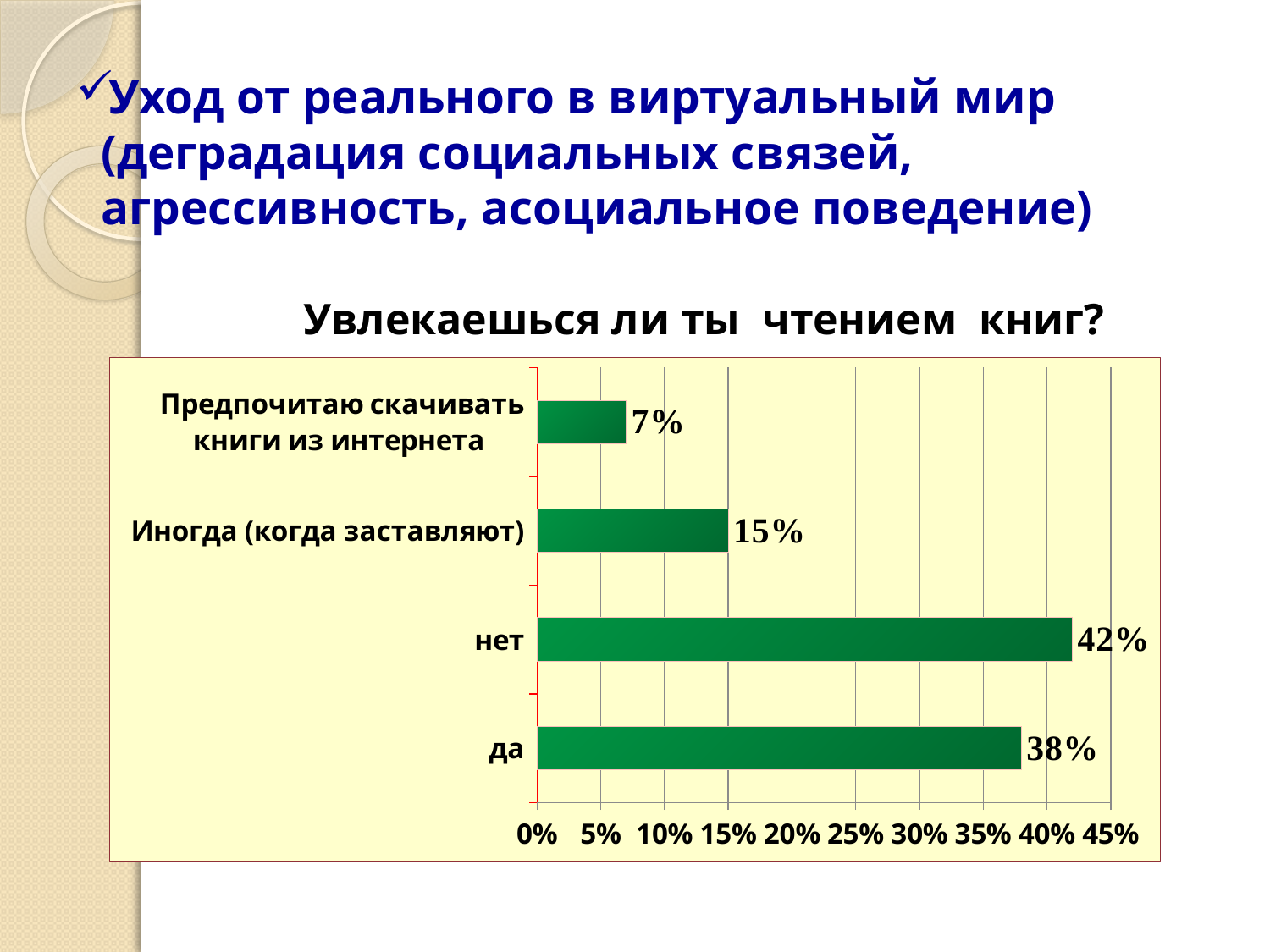
What percentage of respondents answered "да"? 38% What is the value for "Предпочитаю скачивать книги из интернета"? 7% Which answer option has the highest value? нет What type of chart is shown on the slide? Bar chart What is the difference between the values for "Иногда (когда заставляют)" and "Предпочитаю скачивать книги из интернета"? 8% What is the value for "Иногда (когда заставляют)"? 15% Which answer option has the lowest value? Предпочитаю скачивать книги из интернета Which is larger, the value for "да" or the value for "Иногда (когда заставляют)"? да What percentage of respondents answered "нет"? 42% How many answer categories are shown in the chart? 4 What is the title of the chart? Увлекаешься ли ты чтением книг? What is the difference between the values for "нет" and "да"? 4%